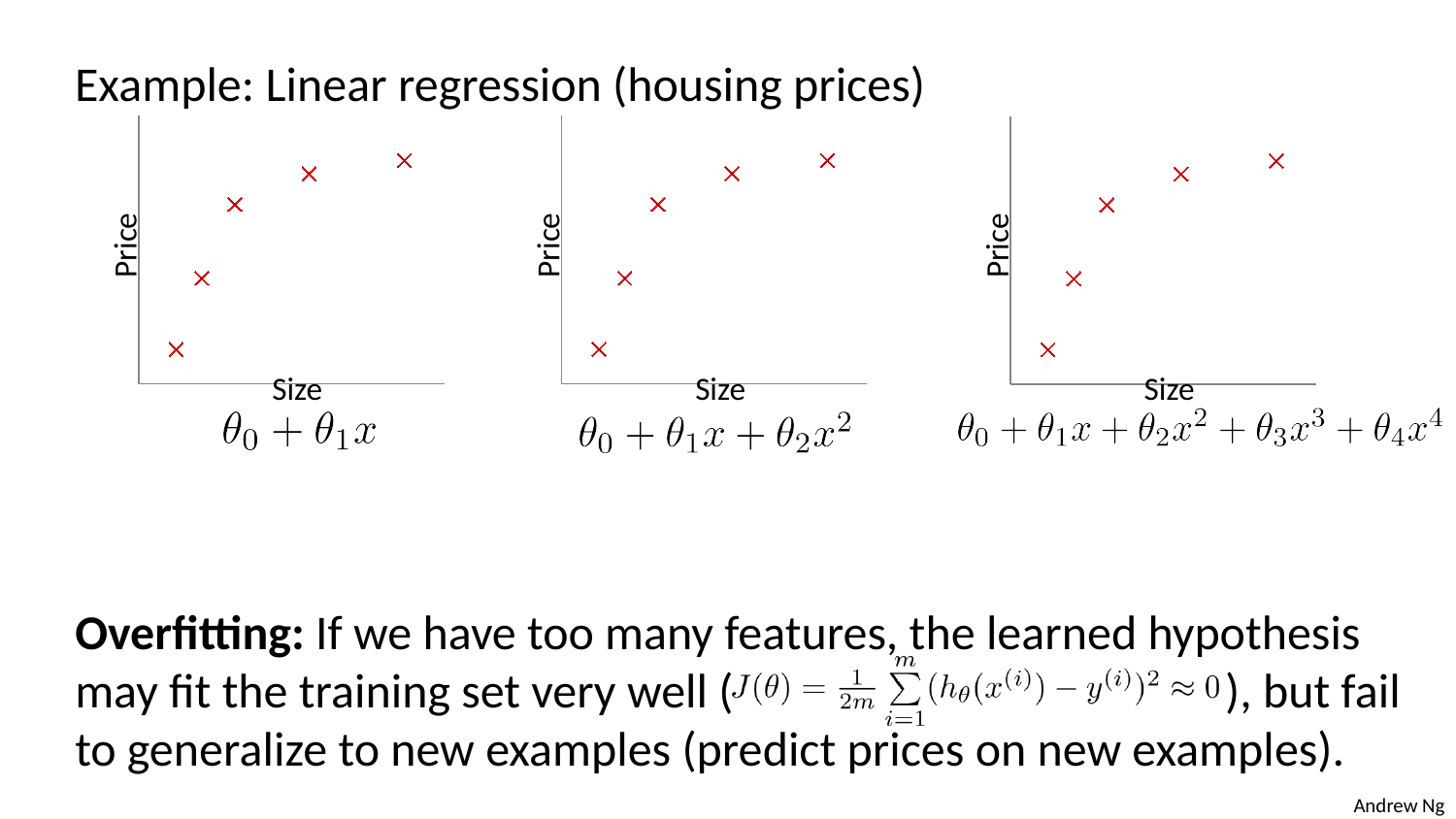
How many data points are plotted in the left chart? 5 In the left chart, do the plotted values rise or fall as Size increases? rise In the left chart, is the point with the smallest Size the lowest or highest in Price? lowest In the right chart, do the plotted values rise or fall along the x axis? rise How many data points are plotted in the right chart? 5 How many data points are plotted in the middle chart? 5 In the middle chart, which point has the highest Price: the one with the largest Size or the one with the smallest Size? the one with the largest Size What is the label of the y axis in the left chart? Price What is the label of the x axis in the middle chart? Size What kind of chart is the left chart on the slide? scatter plot